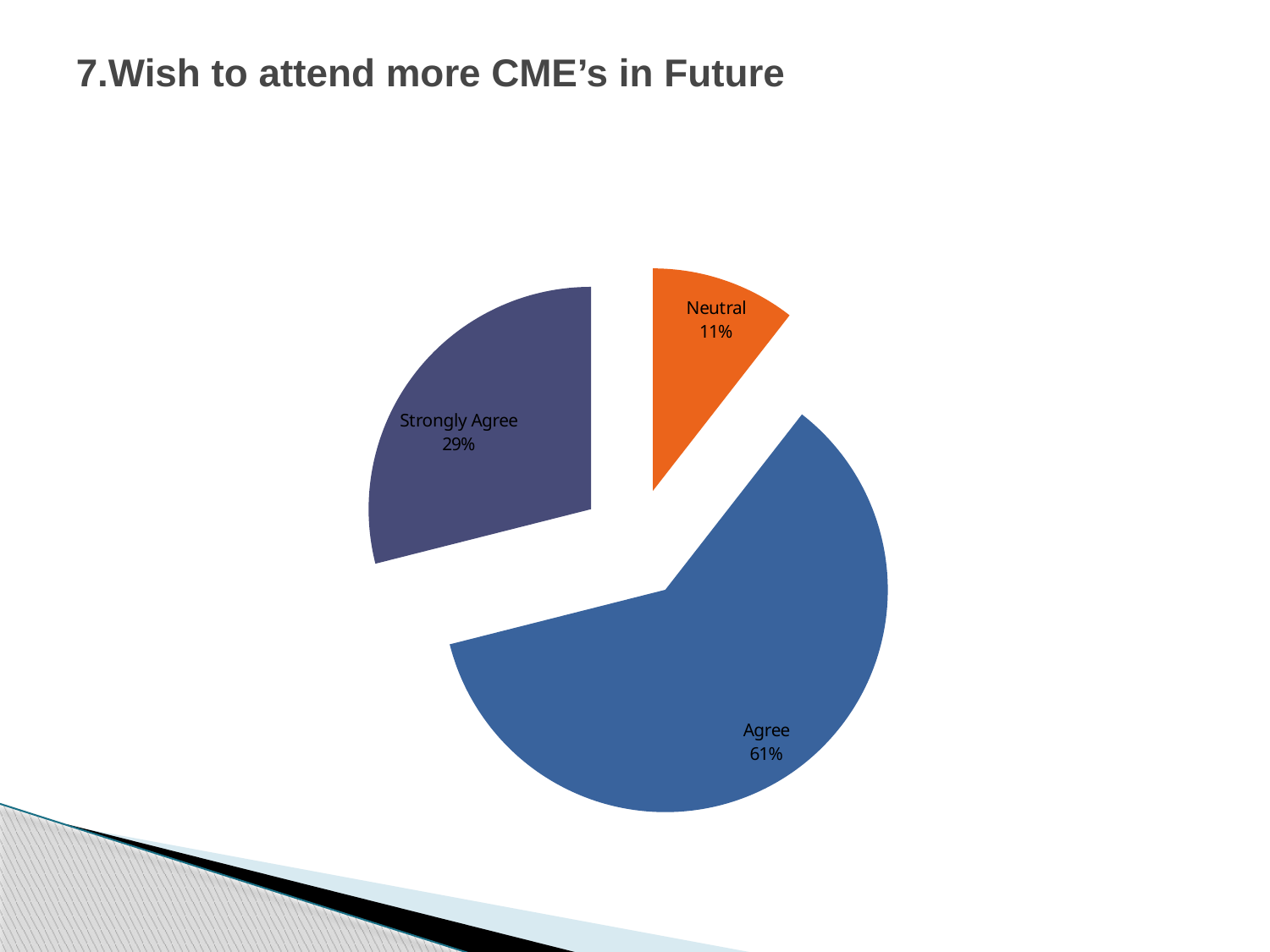
Which is larger, the share for Strongly Agree or the share for Neutral? Strongly Agree What percentage of respondents chose Neutral? 11% How many slices does the pie chart have? 3 What colour is the Neutral slice? Orange Which response has the largest share of the pie? Agree What is the difference in percentage points between Agree and Strongly Agree? 32 What kind of chart is shown on the slide? Pie chart What percentage of respondents chose Agree? 61% What is the difference in percentage points between Strongly Agree and Neutral? 18 What percentage of respondents chose Strongly Agree? 29% What is the title of the slide? 7.Wish to attend more CME's in Future Which response has the smallest share of the pie? Neutral